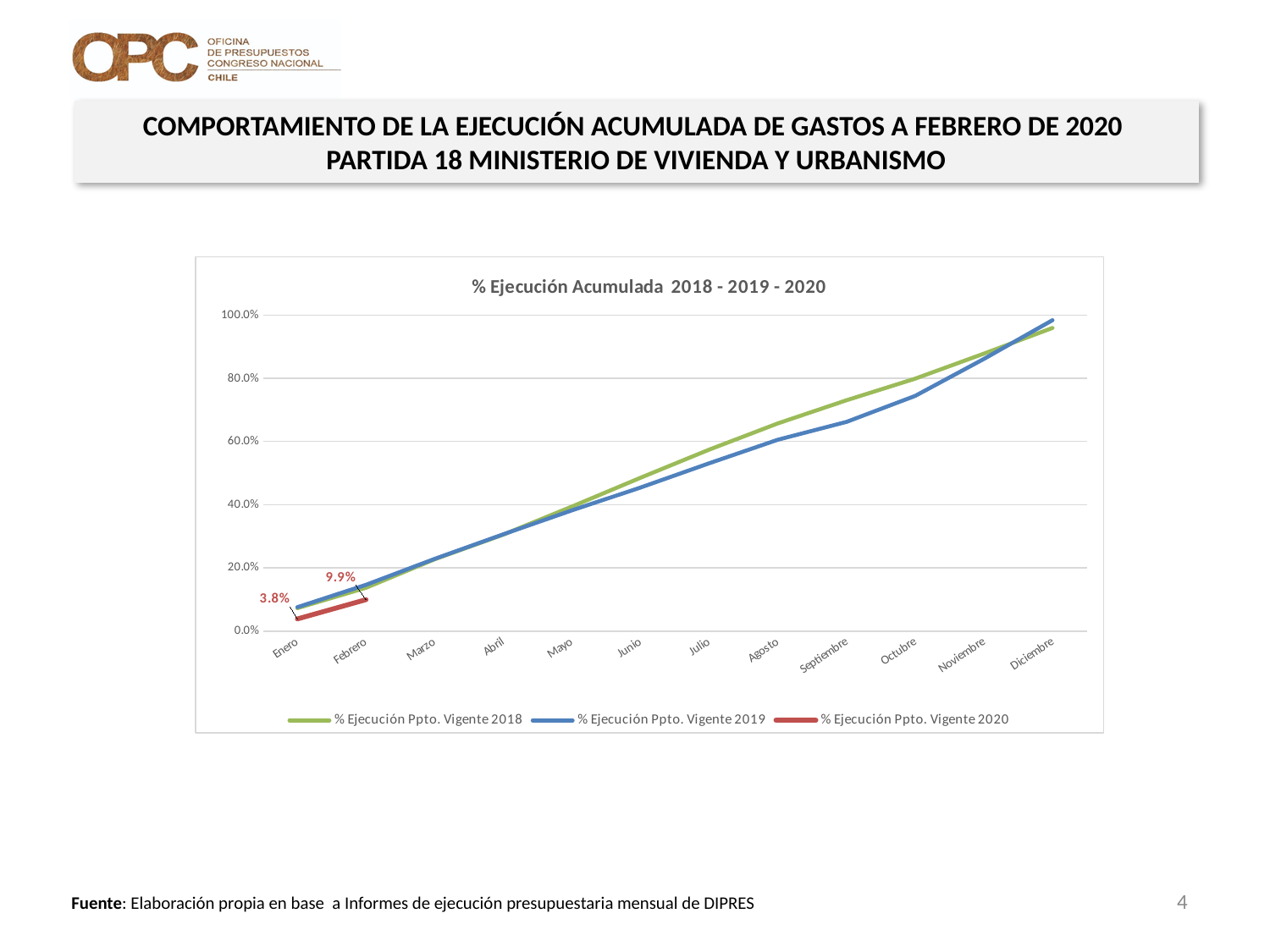
Do the values of the % Ejecución Ppto. Vigente 2019 series rise or fall from Enero to Diciembre? Rise What is the difference between the Febrero and Enero values of the % Ejecución Ppto. Vigente 2020 series? 6.1% How many series does the legend list? 3 What kind of chart is shown on the slide? Line chart What is the value for Febrero in the % Ejecución Ppto. Vigente 2020 series? 9.9% What is the value for Enero in the % Ejecución Ppto. Vigente 2020 series? 3.8% What is the title of the chart? % Ejecución Acumulada 2018 - 2019 - 2020 What colour is the line for % Ejecución Ppto. Vigente 2020? Red Is the value for Diciembre in the % Ejecución Ppto. Vigente 2019 series greater or less than 80.0%? greater How many months are shown on the x axis? 12 Is the value for Agosto in the % Ejecución Ppto. Vigente 2019 series greater or less than 80.0%? less Which series has the larger value in Septiembre, % Ejecución Ppto. Vigente 2018 or % Ejecución Ppto. Vigente 2019? % Ejecución Ppto. Vigente 2018